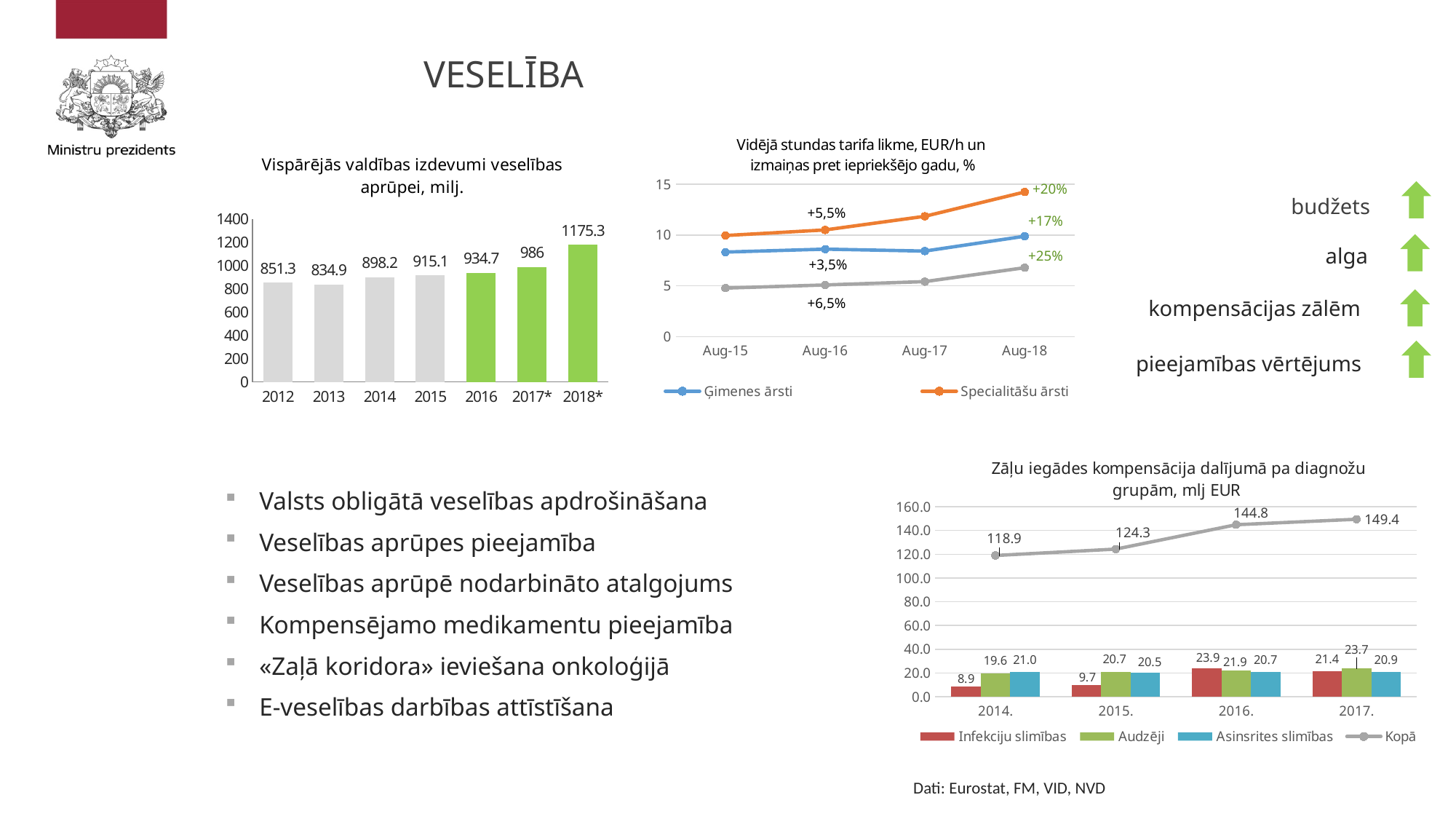
In the chart 'Vispārējās valdības izdevumi veselības aprūpei, milj.', what is the value for 2018*? 1175.3 In the chart 'Vidējā stundas tarifa likme, EUR/h un izmaiņas pret iepriekšējo gadu, %', what percentage change is labelled for Specialitāšu ārsti at Aug-18? +20% In the chart 'Zāļu iegādes kompensācija dalījumā pa diagnožu grupām, mlj EUR', what is the value for Infekciju slimības in 2014.? 8.9 In the chart 'Vispārējās valdības izdevumi veselības aprūpei, milj.', what is the difference between the values for 2018* and 2017*? 189.3 In the chart 'Zāļu iegādes kompensācija dalījumā pa diagnožu grupām, mlj EUR', what is the Kopā value for 2016.? 144.8 How many series does the legend list in the chart 'Vidējā stundas tarifa likme, EUR/h un izmaiņas pret iepriekšējo gadu, %'? 2 What kind of chart is 'Vispārējās valdības izdevumi veselības aprūpei, milj.'? bar chart In the chart 'Zāļu iegādes kompensācija dalījumā pa diagnožu grupām, mlj EUR', which is larger in 2017.: Audzēji or Asinsrites slimības? Audzēji In the chart 'Vispārējās valdības izdevumi veselības aprūpei, milj.', which year has the lowest value? 2013 In the chart 'Vidējā stundas tarifa likme, EUR/h un izmaiņas pret iepriekšējo gadu, %', is the value for Specialitāšu ārsti at Aug-18 greater or less than 10? greater How many years are shown in the chart 'Vispārējās valdības izdevumi veselības aprūpei, milj.'? 7 In the chart 'Zāļu iegādes kompensācija dalījumā pa diagnožu grupām, mlj EUR', does the Kopā line rise or fall from 2014. to 2017.? rise